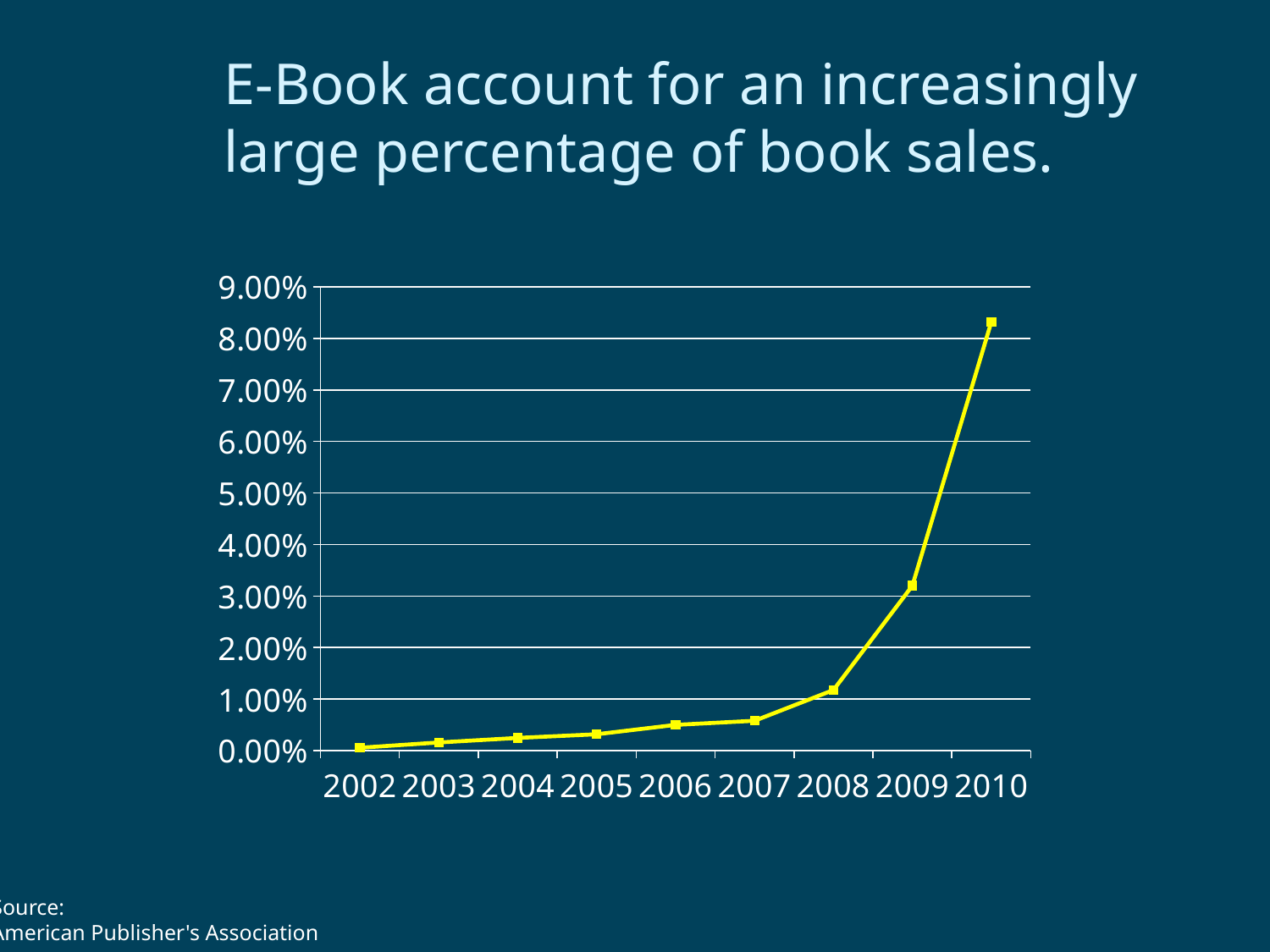
What is the title of the slide? E-Book account for an increasingly large percentage of book sales. Is the value for 2009 greater or less than 3.00%? greater Is the value for 2010 greater or less than 8.00%? greater Which year has the highest value? 2010 Do the values rise or fall from 2002 to 2010? rise What kind of chart is shown on the slide? line chart Which is larger, the value for 2009 or the value for 2008? 2009 Which year has the lowest value? 2002 Is the value for 2008 greater or less than 2.00%? less What colour is the plotted line? yellow How many years are plotted on the x axis? 9